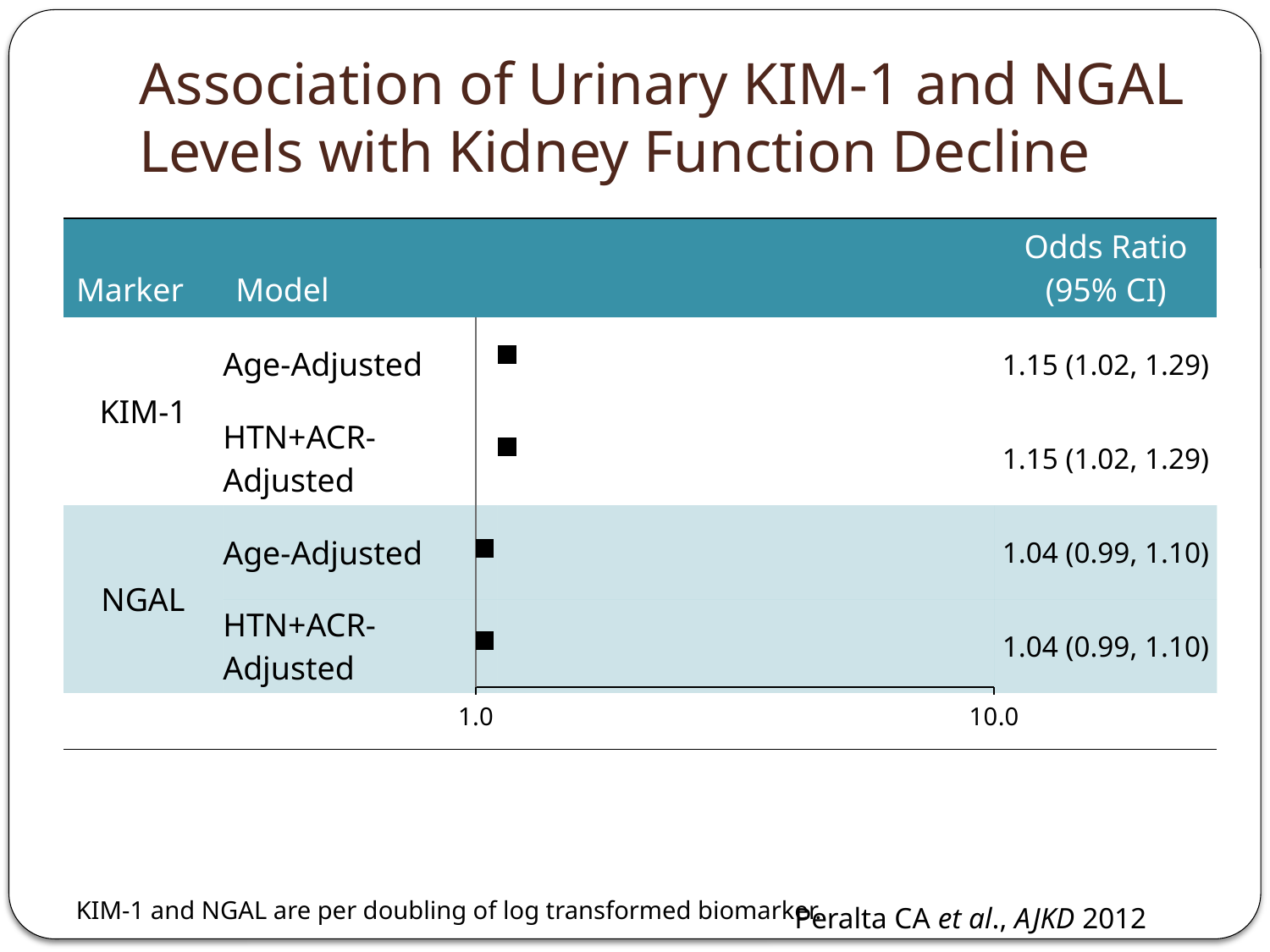
What is the difference between the odds ratio point estimates for KIM-1 and NGAL in the Age-Adjusted model? 0.11 What is the odds ratio point estimate for KIM-1 in the HTN+ACR-Adjusted model? 1.15 Is the odds ratio for KIM-1 in the Age-Adjusted model greater or less than 1.0? greater What is the lower bound of the 95% CI for NGAL in the Age-Adjusted model? 0.99 Which marker has the lowest odds ratio point estimate? NGAL What is the title of the slide? Association of Urinary KIM-1 and NGAL Levels with Kidney Function Decline What are the two tick values shown on the x axis of the plot? 1.0 and 10.0 How many odds ratio estimates (rows) are plotted in the chart? 4 What is the odds ratio (95% CI) for KIM-1 in the Age-Adjusted model? 1.15 (1.02, 1.29) What kind of chart is shown on the slide? Forest plot What is the odds ratio (95% CI) for NGAL in the HTN+ACR-Adjusted model? 1.04 (0.99, 1.10) Which marker has the higher odds ratio, KIM-1 or NGAL? KIM-1